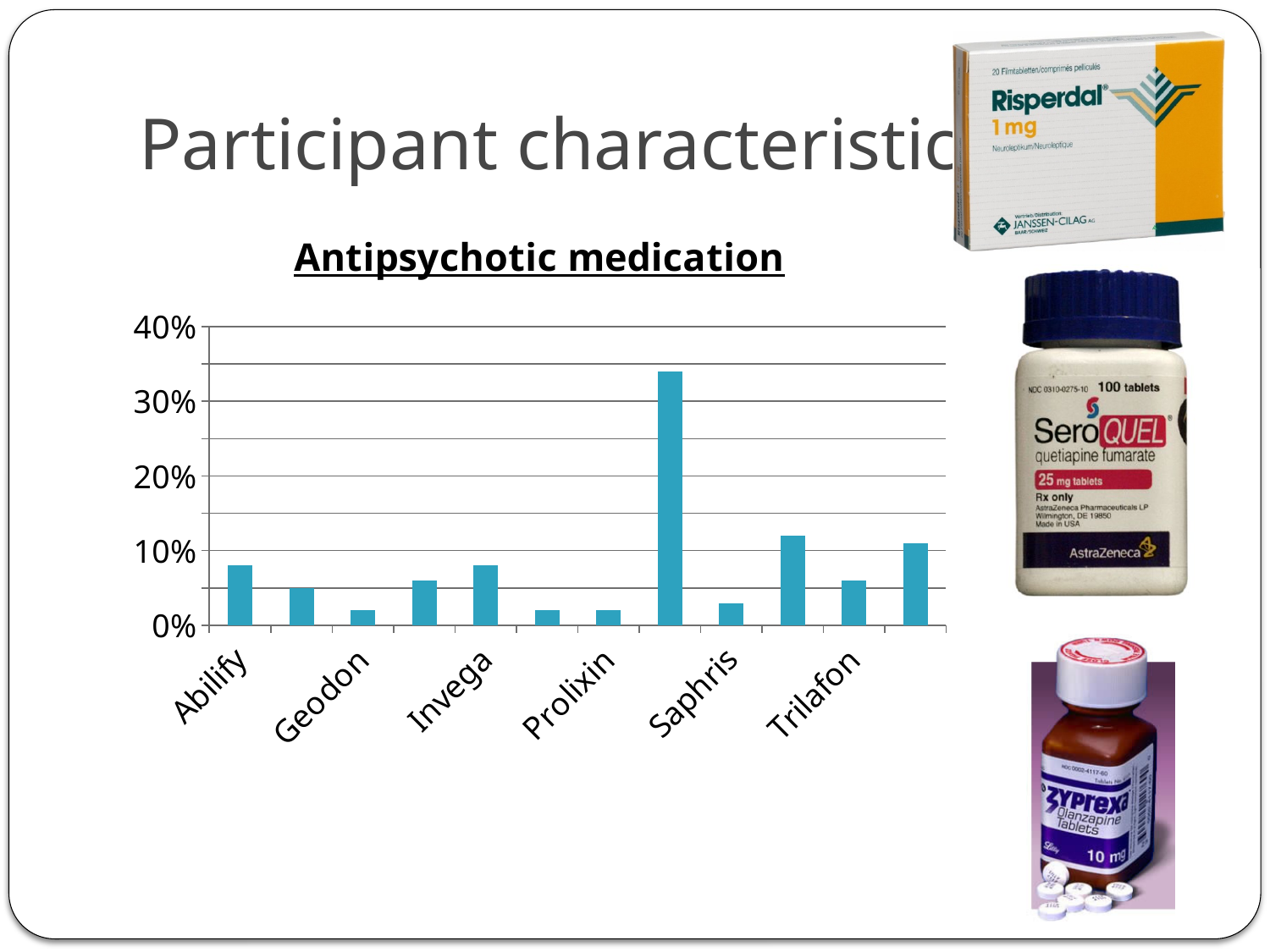
Which has the larger value, Abilify or Prolixin? Abilify Which has the larger value, Invega or Saphris? Invega Is the value for Trilafon greater or less than 10%? less Is the value for Saphris greater or less than 10%? less What kind of chart is shown under the heading 'Antipsychotic medication'? bar chart Is the value for Abilify greater or less than 10%? less Which has the larger value, Trilafon or Prolixin? Trilafon What is the highest value shown on the vertical axis of the chart? 40% How many bars are plotted in the 'Antipsychotic medication' chart? 12 What is the title of the chart on the slide? Antipsychotic medication